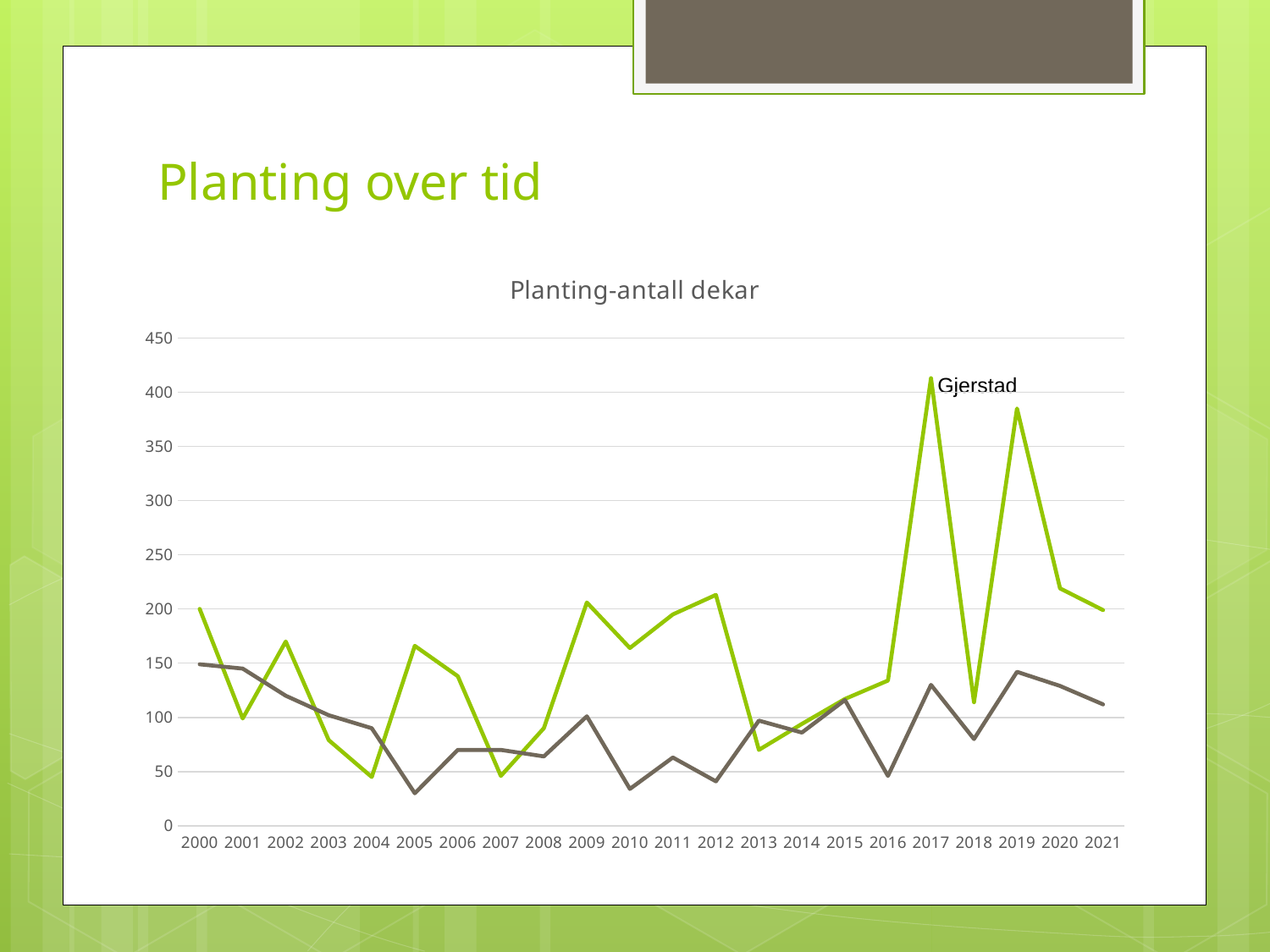
Does the Gjerstad line rise or fall from 2019 to 2021? fall What is the title of the chart? Planting-antall dekar What colour is the line labelled Gjerstad? green In which year does the Gjerstad line reach its highest value? 2017 Is the Gjerstad value for 2013 greater or less than 100? less Is the Gjerstad value for 2017 greater or less than 350? greater How many years are shown along the x axis of the chart? 22 What kind of chart is shown on the slide? line chart Is the Gjerstad value for 2004 greater or less than 100? less Which year has the larger Gjerstad value, 2009 or 2010? 2009 Which year has the larger Gjerstad value, 2017 or 2018? 2017